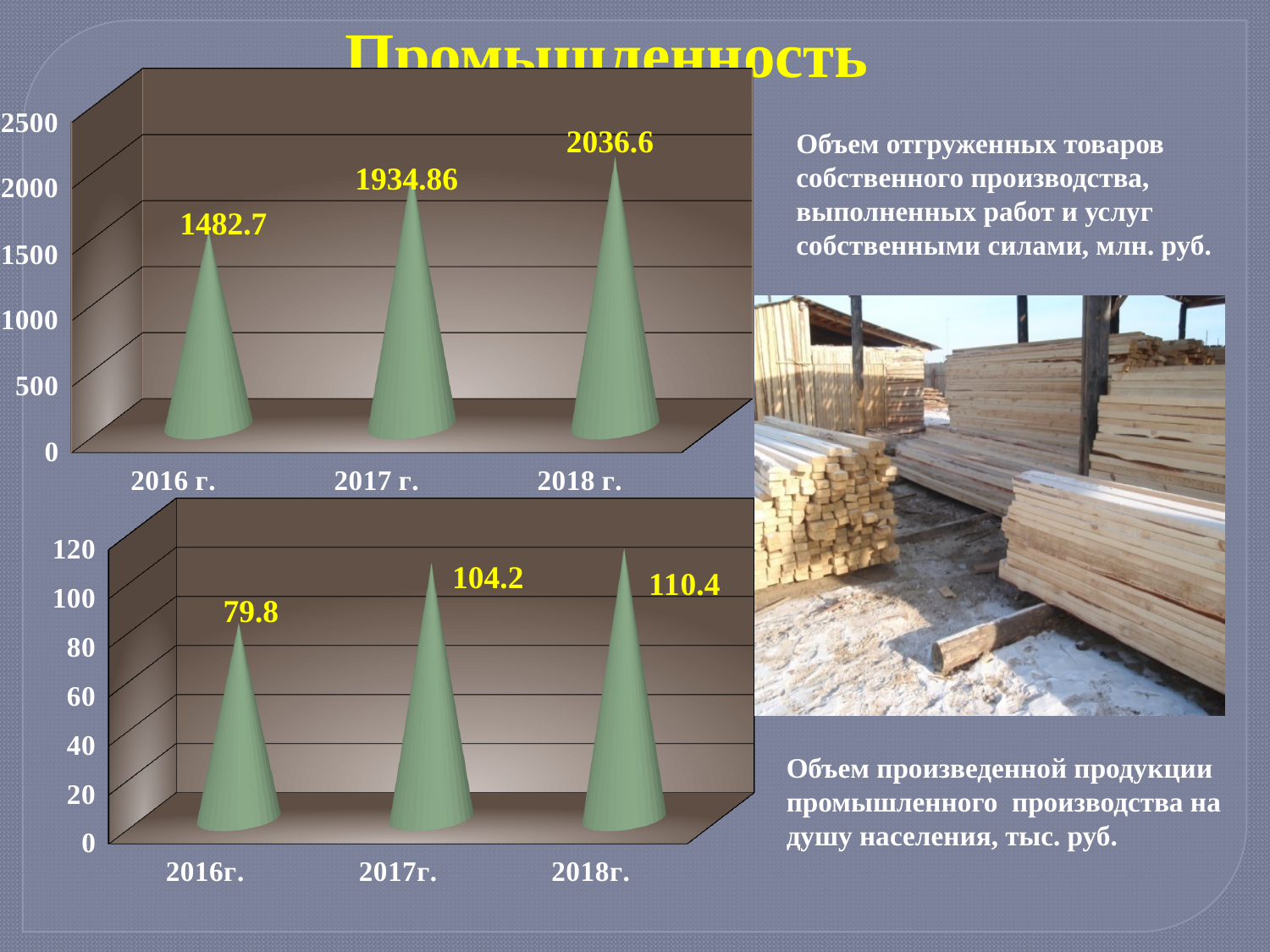
In the bottom chart, is the value for 2017г. greater or less than 100? greater In the bottom chart, what is the difference between the values for 2017г. and 2016г.? 24.4 In the top chart, do the values rise or fall from 2016 г. to 2018 г.? rise In the bottom chart, which year has the lowest value? 2016г. In the top chart, what is the value for 2017 г.? 1934.86 In the top chart, what is the value for 2016 г.? 1482.7 In the top chart, which year has the lowest value? 2016 г. In the top chart, which year has the highest value? 2018 г. In the bottom chart, what is the value for 2018г.? 110.4 In the bottom chart, what is the value for 2016г.? 79.8 How many categories are shown on the x axis of the bottom chart? 3 In the top chart, what is the difference between the values for 2018 г. and 2016 г.? 553.9